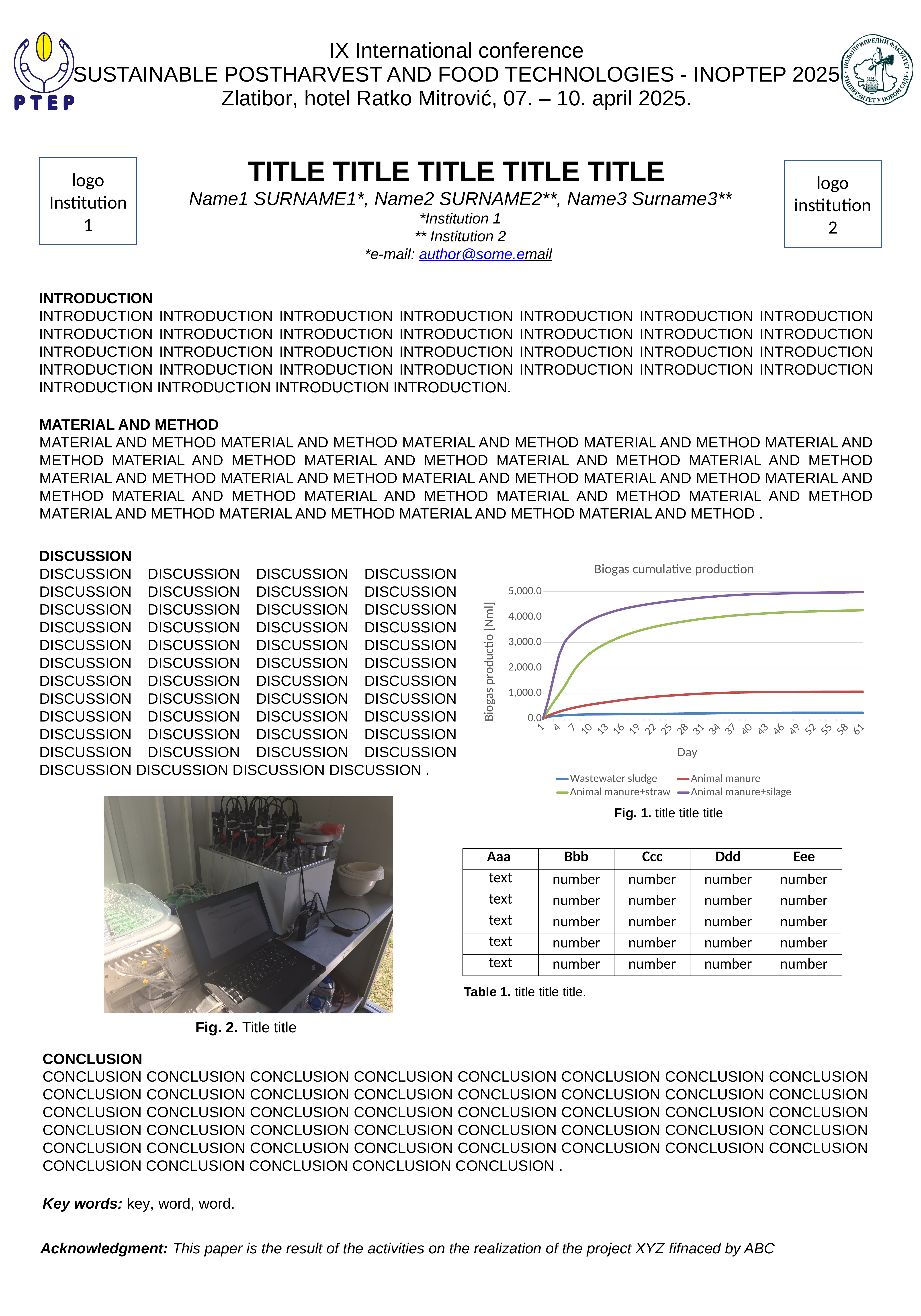
How many series does the legend of the chart list? 4 What is the title of the chart? Biogas cumulative production At day 61, which is larger: Animal manure+straw or Animal manure? Animal manure+straw Is the value for Wastewater sludge at day 61 greater or less than 1,000.0? less Is the value for Animal manure+straw at day 61 greater or less than 3,000.0? greater Which series has the highest cumulative biogas production at day 61? Animal manure+silage Which series has the lowest cumulative biogas production at day 61? Wastewater sludge Is the value for Animal manure at day 61 greater or less than 2,000.0? less What is the label of the x axis of the chart? Day Do the values for Animal manure+silage rise or fall as the day increases? rise What kind of chart is shown on the slide? line chart